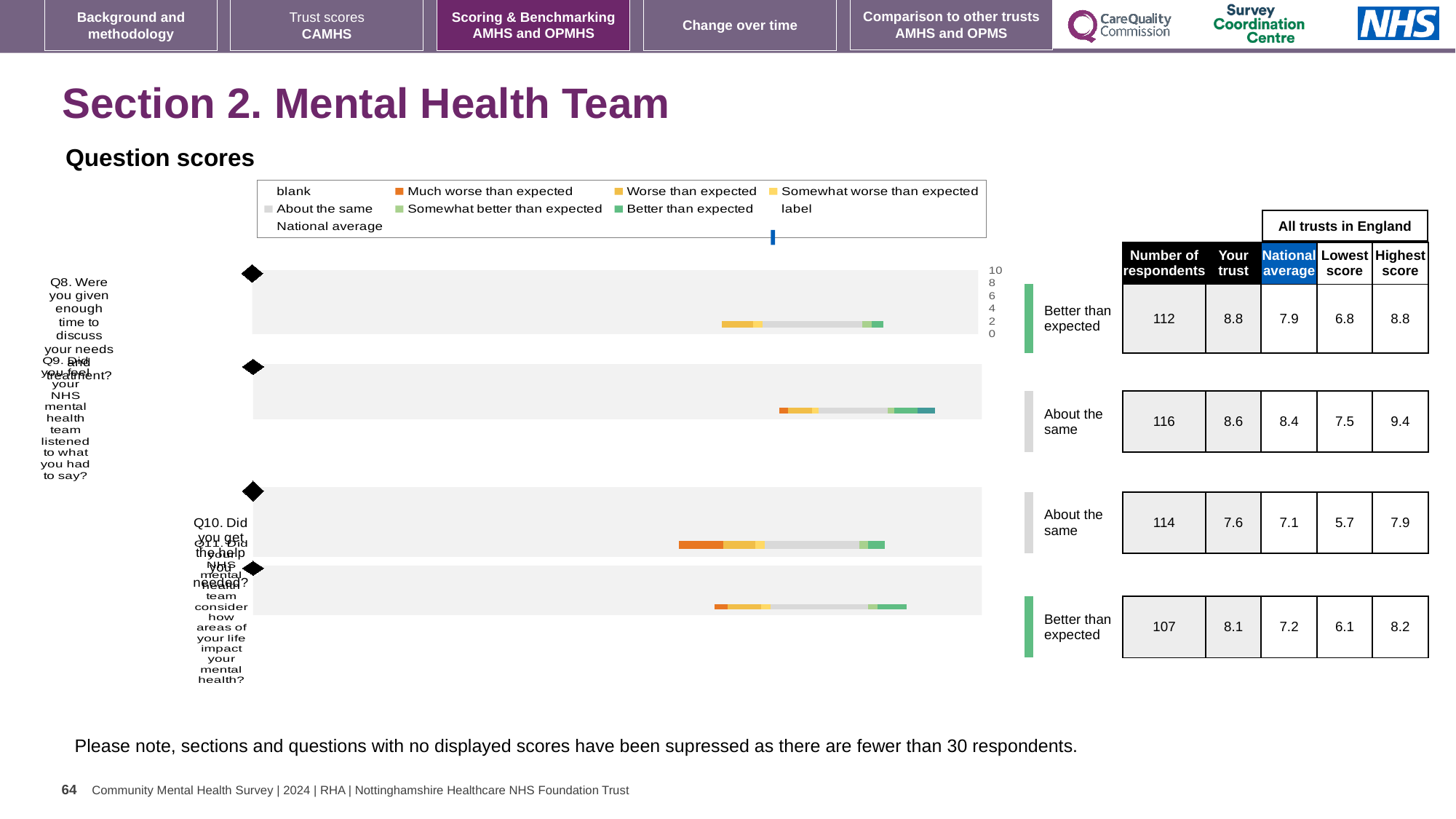
In the table beside the chart, is the 'Your trust' score for the third row (Q10) larger or smaller than its 'National average'? larger How many questions (categories) are plotted in the 'Question scores' chart? 4 What kind of chart is shown under 'Question scores'? bar chart Which legend entry in the 'Question scores' chart is shown in orange? Much worse than expected In the table beside the chart, which row has the highest 'Your trust' score? Q8 (8.8) What is the first question label plotted at the top of the 'Question scores' chart? Q8. Were you given enough time to discuss your needs and treatment? In the table beside the chart, what is the number of respondents for the third row (Q10)? 114 In the table beside the chart, what is the 'National average' for the second row (Q9)? 8.4 How many entries does the legend of the 'Question scores' chart list? 9 In the table beside the chart, what is the difference between 'Your trust' and 'National average' for the first row (Q8)? 0.9 In the table beside the chart, what is the 'Your trust' score for the first row (Q8)? 8.8 In the table beside the chart, what is the 'Highest score' for the fourth row (Q11)? 8.2